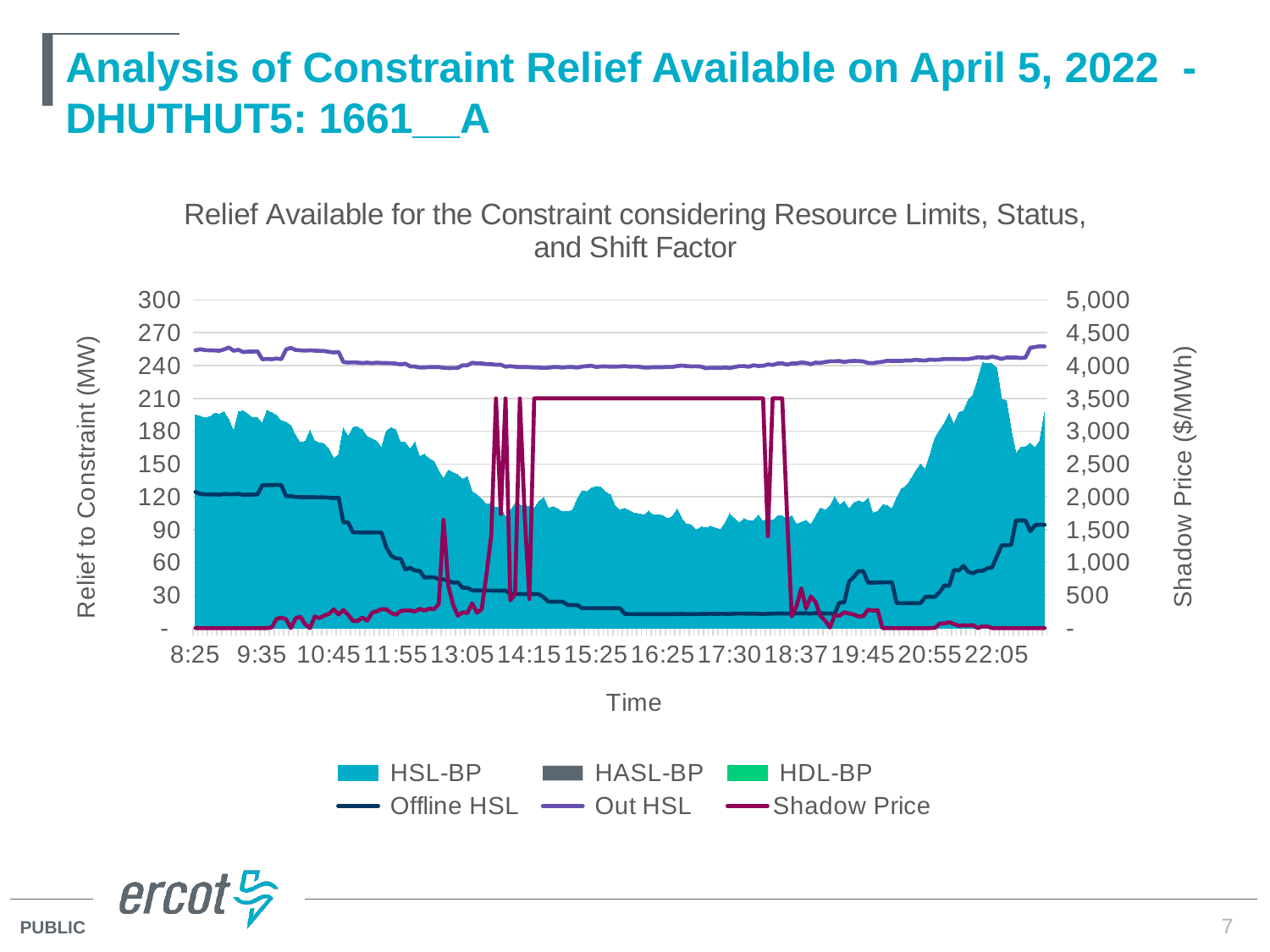
Is the HSL-BP value at 8:25 greater or less than 150 on the left axis? greater Does the Offline HSL line rise or fall from 8:25 to 16:25? fall At 8:25, which is larger on the left axis: HSL-BP or Offline HSL? HSL-BP What is the label of the right-hand vertical axis? Shadow Price ($/MWh) What is the title of the chart? Relief Available for the Constraint considering Resource Limits, Status, and Shift Factor Is the Offline HSL value at 8:25 greater or less than 90 on the left axis? greater Is the Out HSL value at 8:25 greater or less than 4,000 on the right axis? greater At what level on the right axis does the Shadow Price plateau between about 14:15 and 18:37? 3,500 How many time labels are shown along the x axis? 13 What kind of chart is shown on the slide? combination area and line chart How many series does the chart legend list? 6